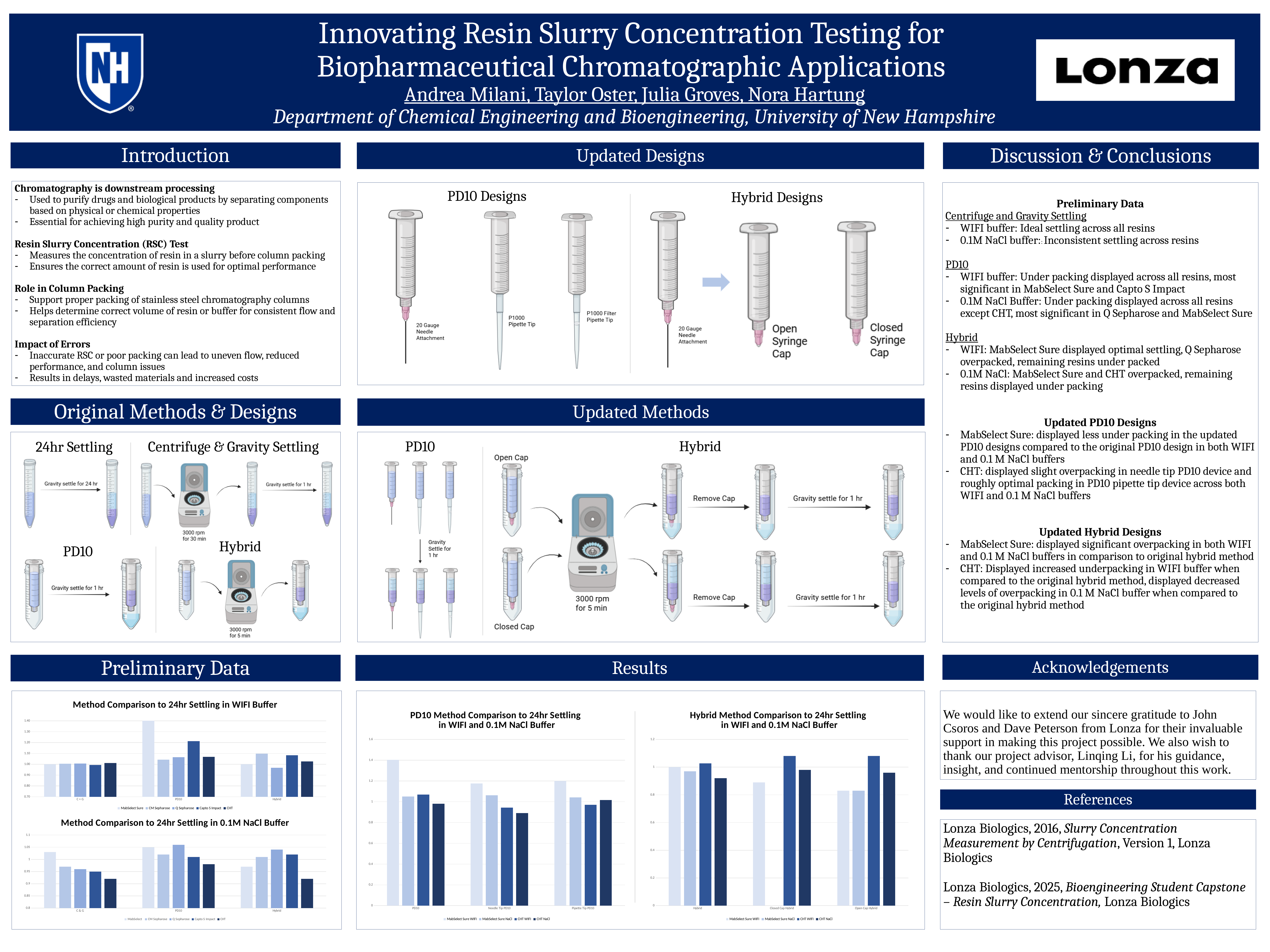
In the 'Hybrid Method Comparison to 24hr Settling in WIFI and 0.1M NaCl Buffer' chart, what are the three categories on the x axis? Hybrid, Closed Cap Hybrid, Open Cap Hybrid In the 'PD10 Method Comparison to 24hr Settling in WIFI and 0.1M NaCl Buffer' chart, which is larger for Pipette Tip PD10: MabSelect Sure WIFI or CHT WIFI? MabSelect Sure WIFI In the 'PD10 Method Comparison to 24hr Settling in WIFI and 0.1M NaCl Buffer' chart, is the CHT NaCl value for Needle Tip PD10 greater or less than 1? less In the 'Method Comparison to 24hr Settling in WIFI Buffer' chart, is the MabSelect Sure value for PD10 greater or less than 1.30? greater In the 'Method Comparison to 24hr Settling in WIFI Buffer' chart, how many series does the legend list? 5 In the 'Method Comparison to 24hr Settling in WIFI Buffer' chart, what kind of chart is shown? bar chart In the 'PD10 Method Comparison to 24hr Settling in WIFI and 0.1M NaCl Buffer' chart, how many series does the legend list? 4 In the 'Method Comparison to 24hr Settling in WIFI Buffer' chart, which method has the tallest bar for MabSelect Sure? PD10 In the 'Method Comparison to 24hr Settling in 0.1M NaCl Buffer' chart, how many method categories are shown on the x axis? 3 In the 'PD10 Method Comparison to 24hr Settling in WIFI and 0.1M NaCl Buffer' chart, which category has the tallest MabSelect Sure WIFI bar? PD10 In the 'Method Comparison to 24hr Settling in 0.1M NaCl Buffer' chart, is the CHT value for Hybrid greater or less than 0.95? less